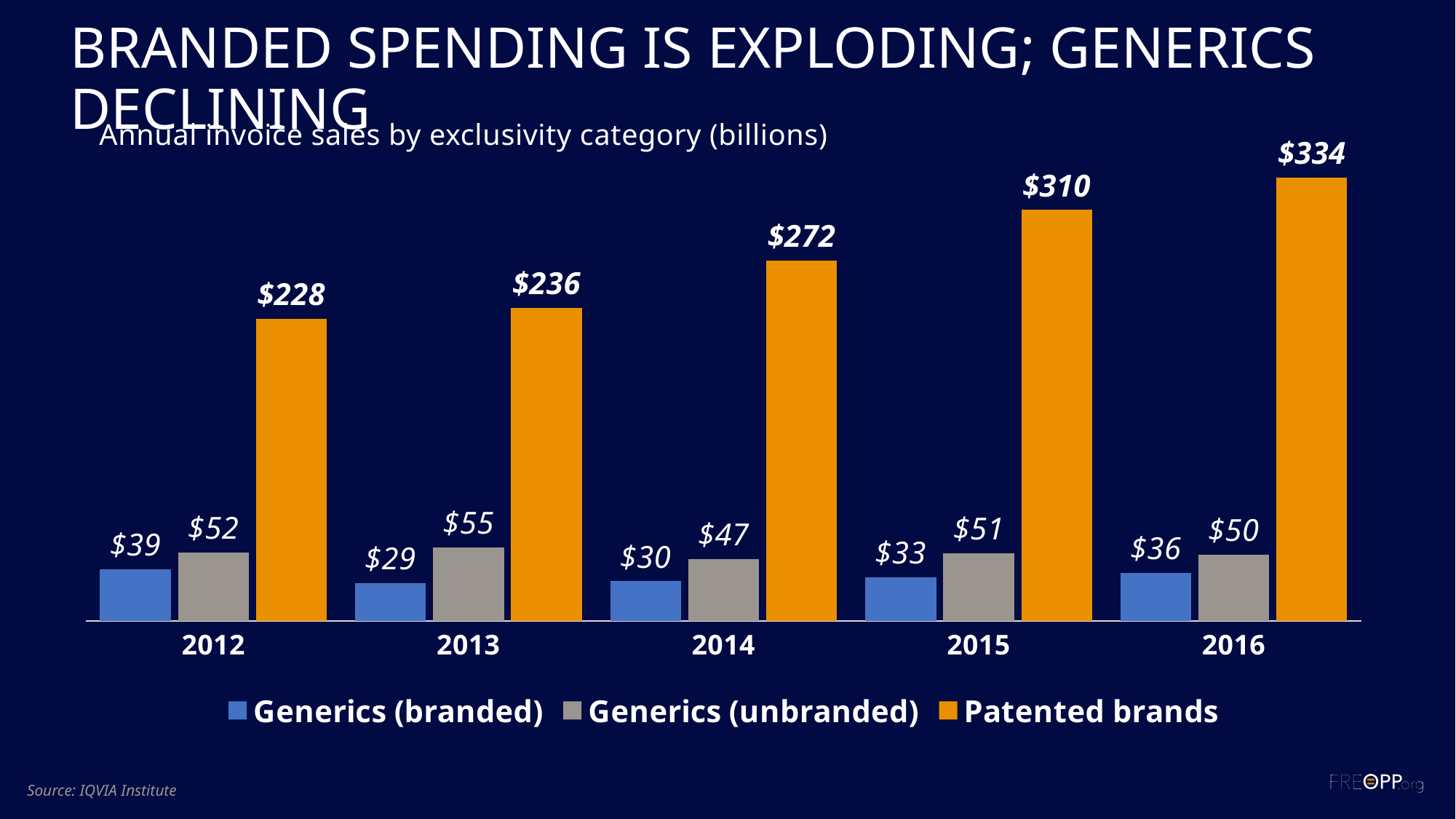
What kind of chart is shown on the slide? Bar chart What is the value for Generics (unbranded) in 2014? $47 Do the Patented brands values rise or fall from 2012 to 2016? Rise How many years are shown on the x axis? 5 How many series does the legend list? 3 What colour are the Patented brands bars? Orange What is the value for Patented brands in 2016? $334 In which year is the Generics (branded) value lowest? 2013 What is the value for Generics (branded) in 2013? $29 Which is larger in 2015: Generics (branded) or Generics (unbranded)? Generics (unbranded) What is the difference between the Patented brands values for 2016 and 2012? $106 In which year is the Patented brands value highest? 2016